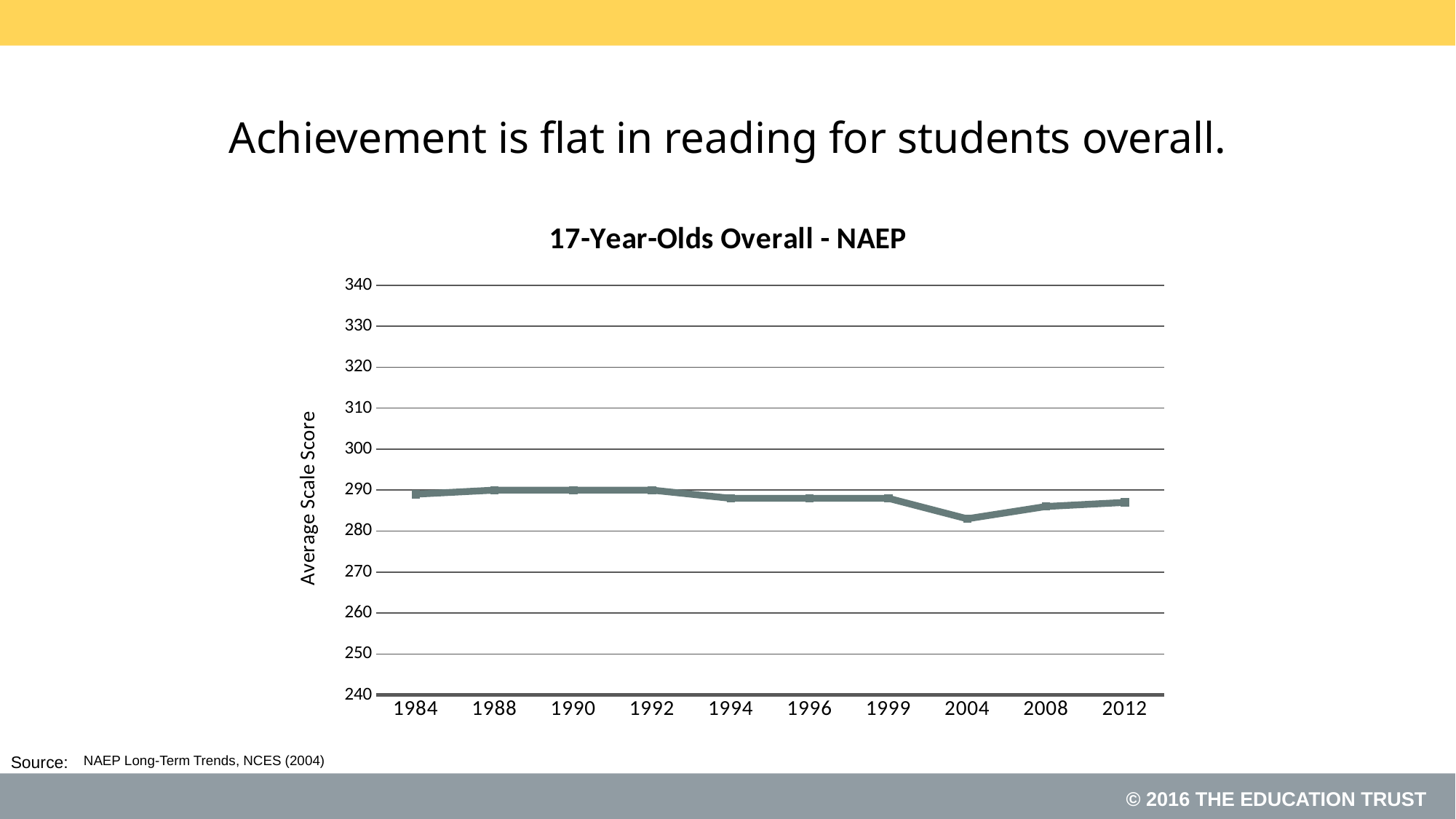
Is the value for 1984 greater or less than 280? greater Is the value for 1992 greater or less than 300? less Do the values rise or fall from 2004 to 2012? rise Which year has the lowest average scale score on the chart? 2004 What kind of chart is shown on the slide? line chart Is the value for 2004 greater or less than 290? less Do the values rise or fall from 1992 to 2004? fall What is the label on the vertical axis of the chart? Average Scale Score What is the title of the chart? 17-Year-Olds Overall - NAEP How many years are plotted along the x axis of the chart? 10 Which year has the larger average scale score, 1992 or 2004? 1992